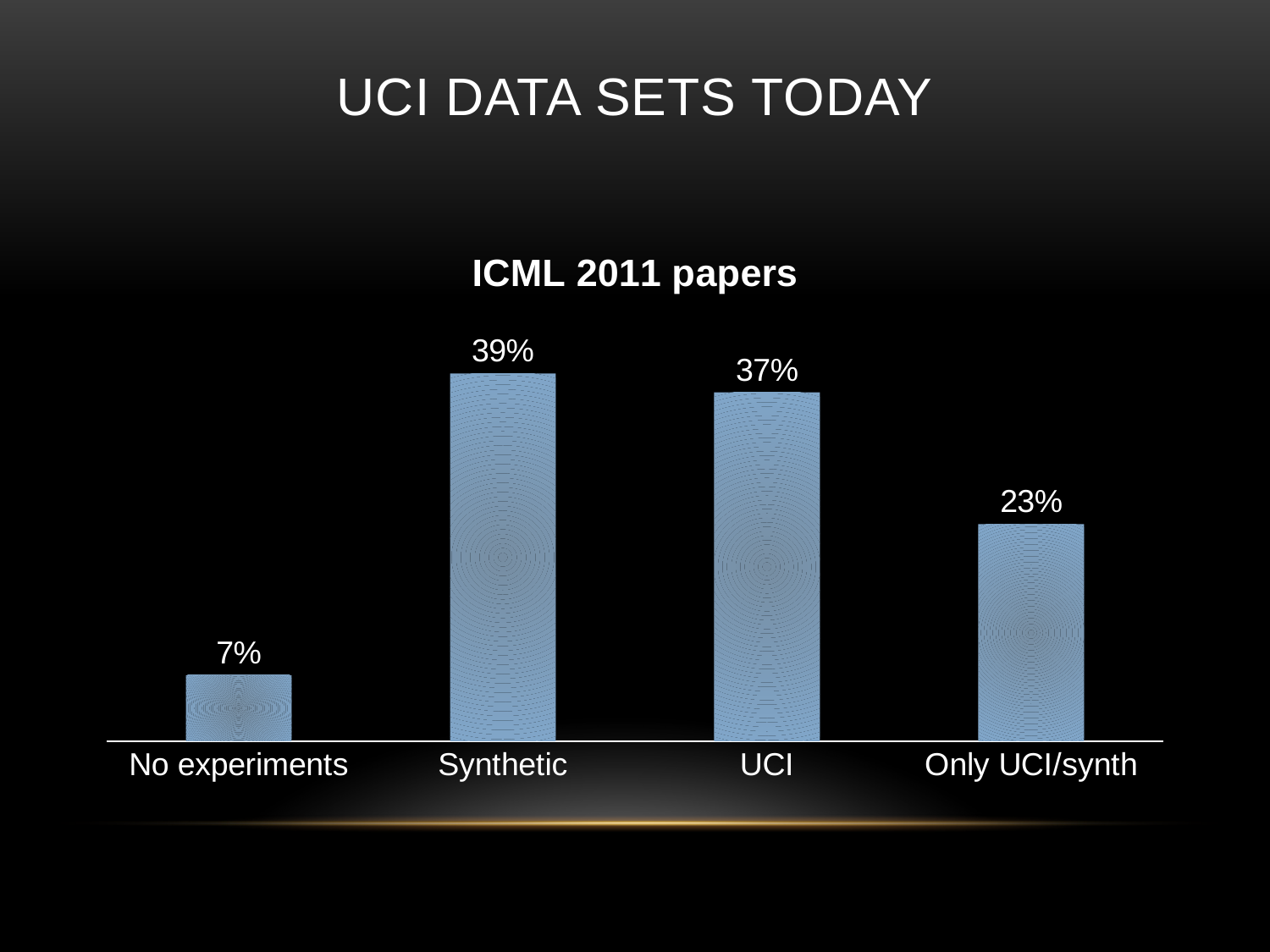
What is the value for UCI? 37% How many categories are shown in the chart? 4 Which category has the highest value? Synthetic What is the value for Synthetic? 39% Which category has the lowest value? No experiments What is the value for Only UCI/synth? 23% What is the difference between the values for Synthetic and UCI? 2% What is the difference between the values for UCI and Only UCI/synth? 14% What kind of chart is shown on the slide? Bar chart Which is larger, the value for Only UCI/synth or the value for No experiments? Only UCI/synth What is the title of the chart? ICML 2011 papers What is the value for No experiments? 7%